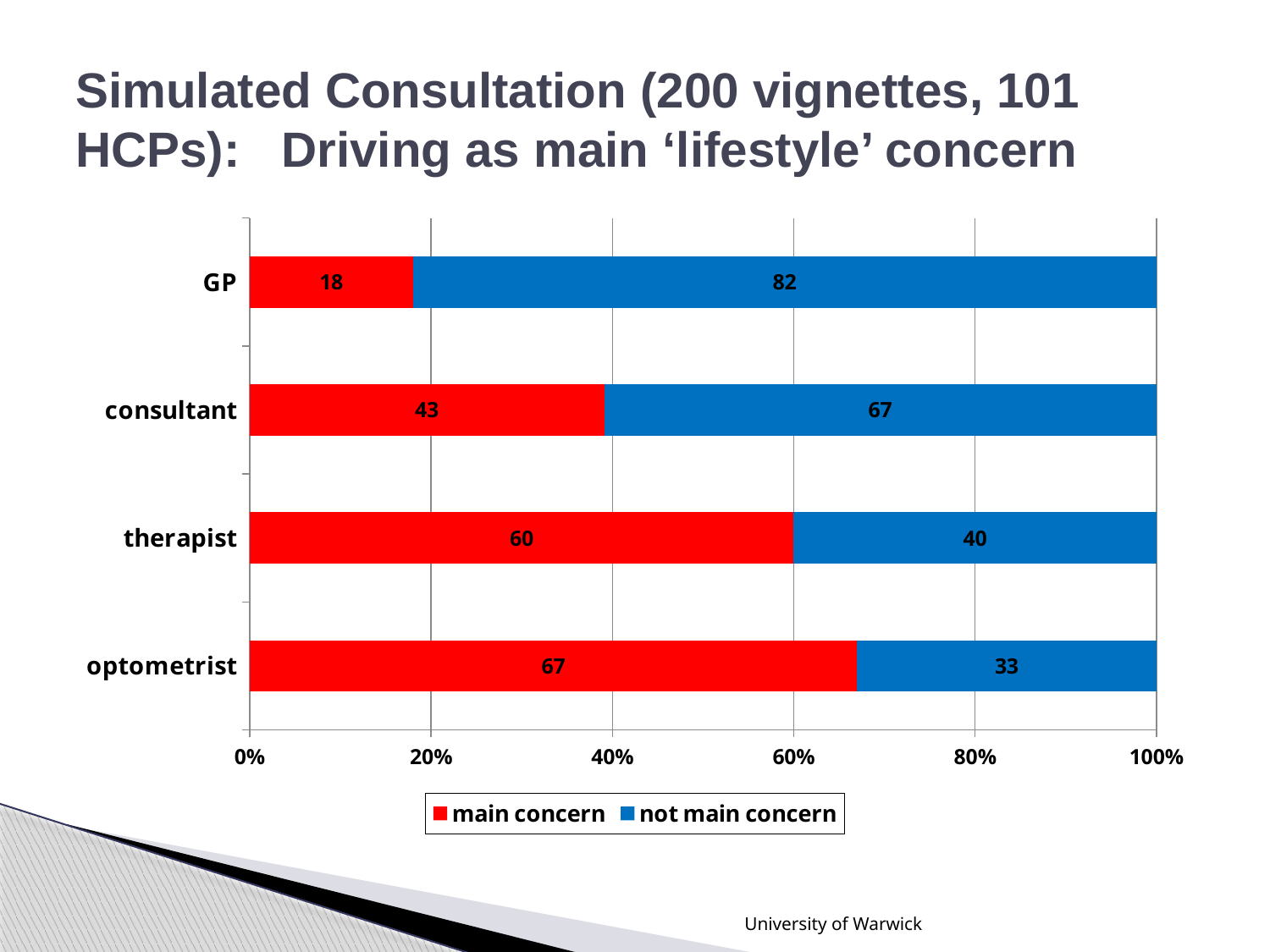
Which colour represents 'not main concern' in the legend? blue What is the 'main concern' value for GP? 18 Which is larger, the 'main concern' value for therapist or for consultant? therapist Which category has the highest 'main concern' value? optometrist What is the difference between the 'main concern' values for optometrist and GP? 49 What is the 'not main concern' value for therapist? 40 Which category has the lowest 'main concern' value? GP How many series does the legend list? 2 What is the 'not main concern' value for consultant? 67 How many categories are shown on the chart? 4 What kind of chart is shown on the slide? stacked bar chart What is the 'main concern' value for optometrist? 67